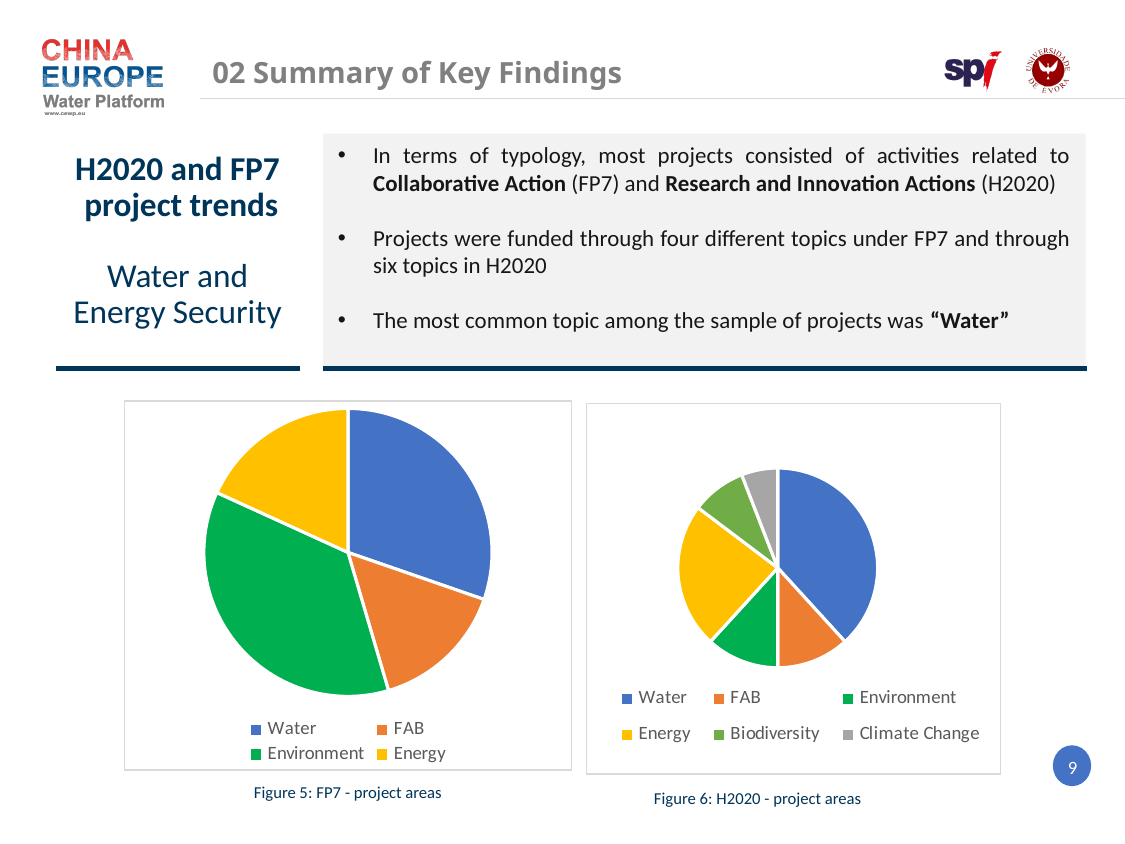
What kind of chart is Figure 5: FP7 - project areas? pie chart How many project areas are shown in the Figure 5: FP7 - project areas pie chart? 4 What colour represents Energy in both pie charts on the slide? yellow In Figure 5: FP7 - project areas, which slice is larger, Environment or Energy? Environment In Figure 6: H2020 - project areas, which project area has the largest slice? Water In Figure 6: H2020 - project areas, which project area has the smallest slice? Climate Change In Figure 6: H2020 - project areas, which slice is larger, Energy or FAB? Energy What kind of chart is Figure 6: H2020 - project areas? pie chart In Figure 5: FP7 - project areas, which slice is larger, Water or FAB? Water Which legend entries appear in Figure 6: H2020 - project areas but not in Figure 5: FP7 - project areas? Biodiversity and Climate Change How many project areas are shown in the Figure 6: H2020 - project areas pie chart? 6